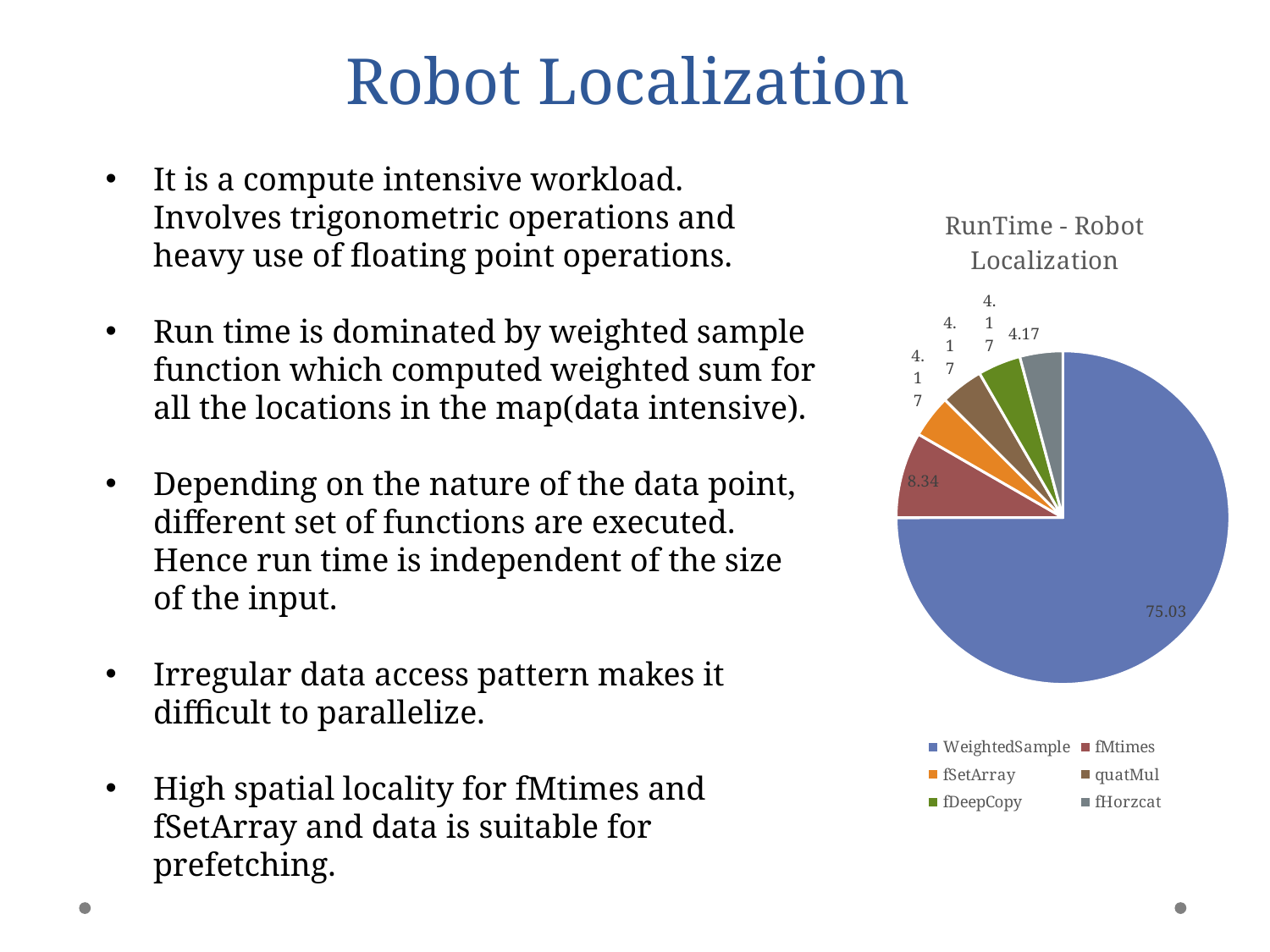
What is the value for fSetArray in the RunTime - Robot Localization pie chart? 4.17 What colour is the WeightedSample slice in the RunTime - Robot Localization pie chart? Blue Which category has the largest slice in the RunTime - Robot Localization pie chart? WeightedSample What is the value for fMtimes in the RunTime - Robot Localization pie chart? 8.34 What is the difference between the WeightedSample and fMtimes values in the RunTime - Robot Localization pie chart? 66.69 What is the value for WeightedSample in the RunTime - Robot Localization pie chart? 75.03 How many slices does the RunTime - Robot Localization pie chart have? 6 How many entries does the legend of the RunTime - Robot Localization chart list? 6 What is the value for fHorzcat in the RunTime - Robot Localization pie chart? 4.17 What is the title of the chart on the slide? RunTime - Robot Localization What kind of chart is shown on the slide? Pie chart Which is larger in the RunTime - Robot Localization pie chart, fMtimes or quatMul? fMtimes